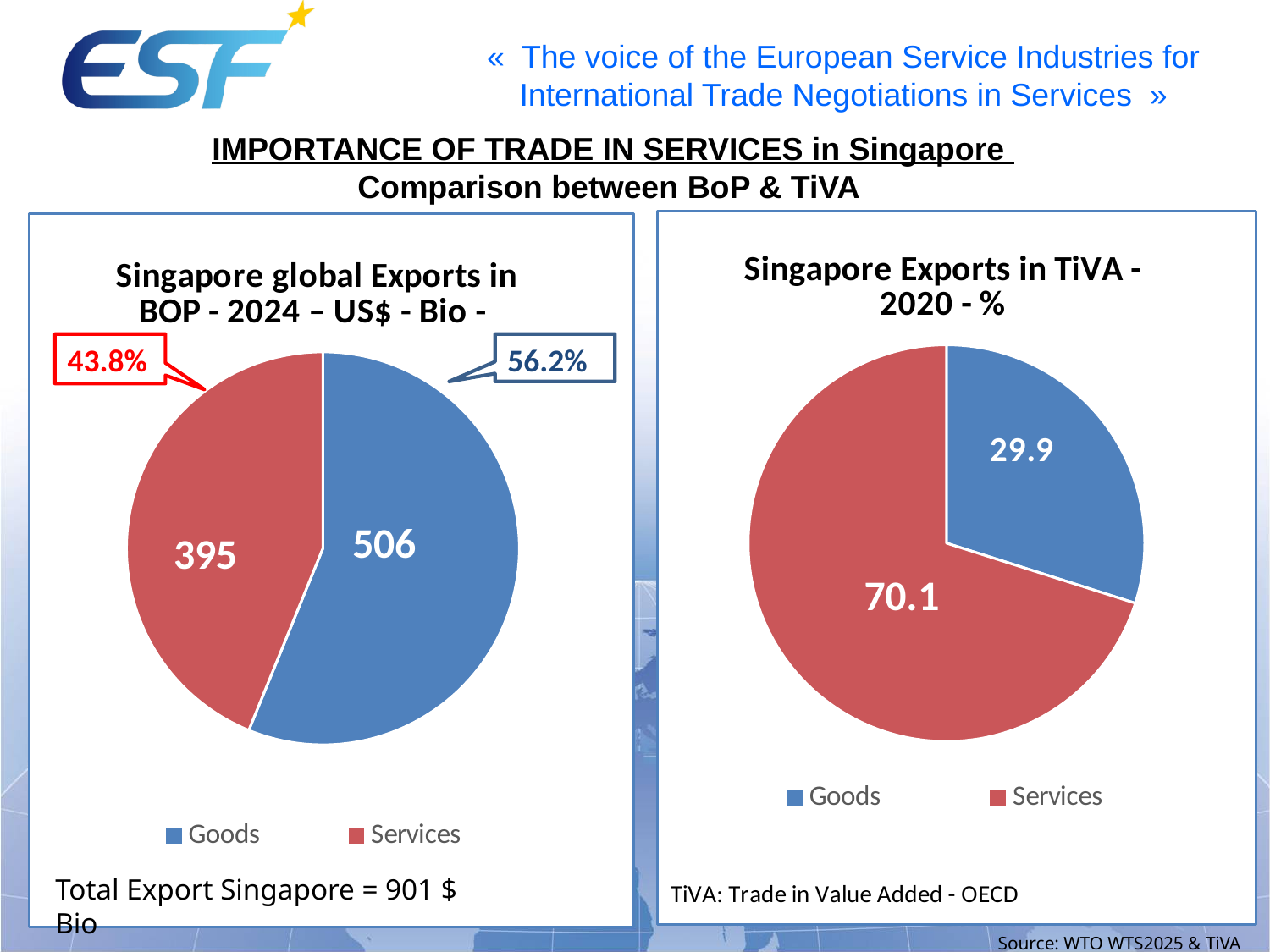
In the right chart (Singapore Exports in TiVA - 2020), which category has the smallest slice? Goods In the left chart (Singapore global Exports in BOP - 2024), what share of the pie does Services represent according to the callout label? 43.8% In the left chart (Singapore global Exports in BOP - 2024), what is the value for Services? 395 In the left chart (Singapore global Exports in BOP - 2024), what is the difference between the Goods and Services values? 111 In the left chart (Singapore global Exports in BOP - 2024), which category has the largest slice? Goods In the right chart (Singapore Exports in TiVA - 2020), is the value for Services larger or smaller than the value for Goods? larger In the left chart (Singapore global Exports in BOP - 2024), what is the value for Goods? 506 How many series does the legend of the left chart (Singapore global Exports in BOP - 2024) list? 2 In the left chart (Singapore global Exports in BOP - 2024), what share of the pie does Goods represent according to the callout label? 56.2% What kind of chart is the right chart (Singapore Exports in TiVA - 2020)? pie chart In the right chart (Singapore Exports in TiVA - 2020), what is the value for Services? 70.1 In the right chart (Singapore Exports in TiVA - 2020), what is the value for Goods? 29.9